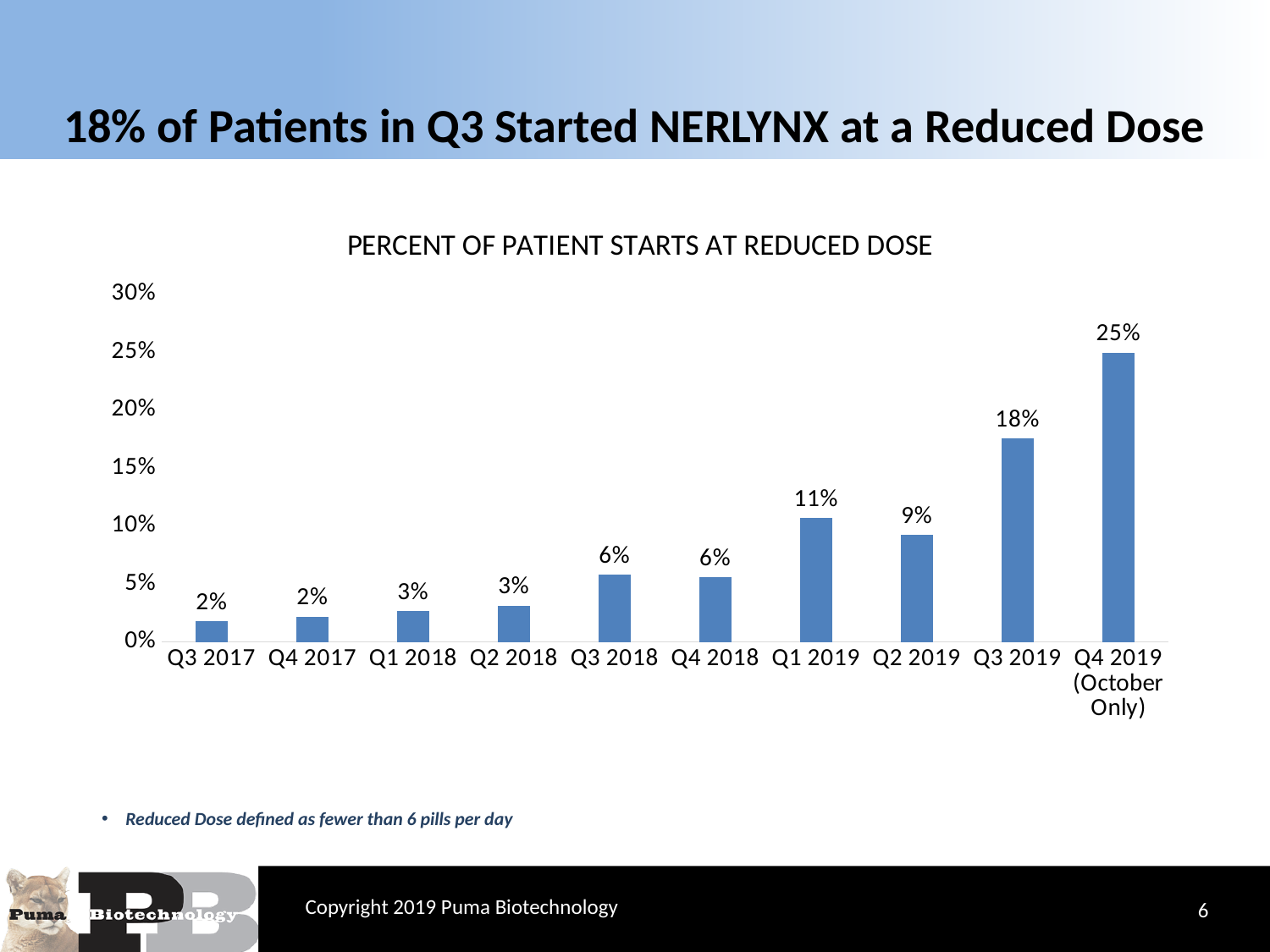
What is the difference between the values for Q4 2019 (October Only) and Q3 2019? 7% What is the title of the chart? PERCENT OF PATIENT STARTS AT REDUCED DOSE Which is larger, the value for Q2 2019 or the value for Q3 2019? Q3 2019 Do the values generally rise or fall from Q3 2017 to Q4 2019 (October Only)? Rise What kind of chart is shown on the slide? Bar chart Which quarter has the highest percent of patient starts at reduced dose? Q4 2019 (October Only) Is the value for Q3 2019 greater or less than 15%? greater What is the difference between the values for Q1 2019 and Q2 2019? 2% What is the value shown for Q4 2019 (October Only)? 25% What is the percent of patient starts at reduced dose for Q3 2019? 18% How many quarters are shown on the x axis of the chart? 10 What is the percent of patient starts at reduced dose for Q1 2019? 11%